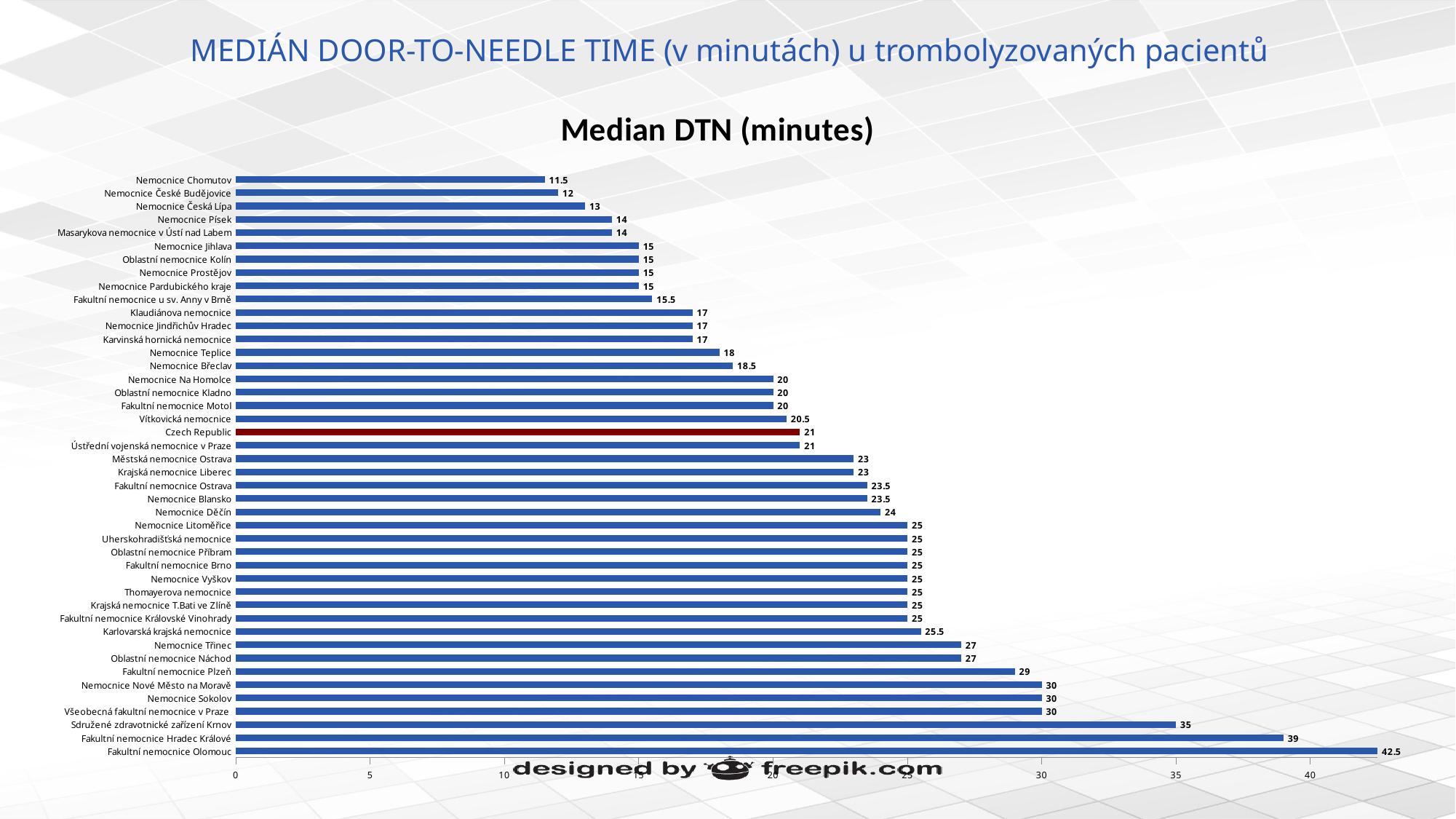
What is the difference in median DTN between Fakultní nemocnice Olomouc and Nemocnice Chomutov? 31 What type of chart is shown on the slide? Bar chart What is the median DTN for Nemocnice Chomutov? 11.5 Which hospital has the highest median DTN? Fakultní nemocnice Olomouc Which has a larger median DTN, Fakultní nemocnice Plzeň or Nemocnice Třinec? Fakultní nemocnice Plzeň Which hospital has the lowest median DTN? Nemocnice Chomutov What is the median DTN for Fakultní nemocnice Hradec Králové? 39 How many categories (bars) are shown in the chart? 44 Which bar is highlighted in a different colour (dark red) from the others? Czech Republic What is the median DTN for Czech Republic? 21 What is the median DTN for Nemocnice Břeclav? 18.5 What is the difference in median DTN between Sdružené zdravotnické zařízení Krnov and Czech Republic? 14